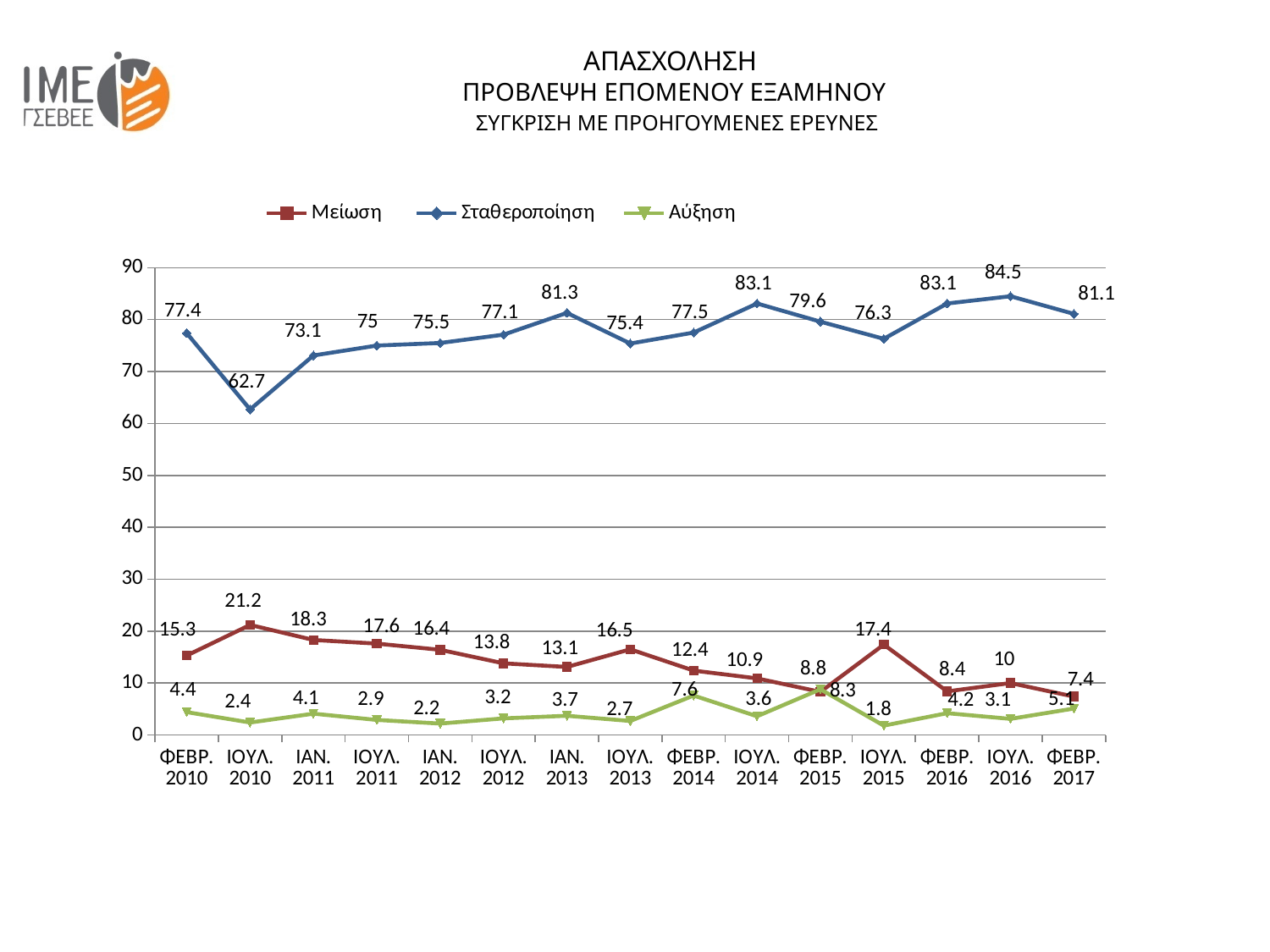
What is the difference between the Σταθεροποίηση values for ΙΟΥΛ. 2016 and ΦΕΒΡ. 2017? 3.4 In which period does Σταθεροποίηση have its lowest value? ΙΟΥΛ. 2010 In which period does Σταθεροποίηση reach its highest value? ΙΟΥΛ. 2016 How many survey periods are shown on the x axis? 15 What is the value of Μείωση for ΙΟΥΛ. 2015? 17.4 Which is larger, the Μείωση value for ΦΕΒΡ. 2010 or for ΙΑΝ. 2011? ΙΑΝ. 2011 What is the value of Αύξηση for ΦΕΒΡ. 2017? 5.1 Which series is shown in blue in the legend? Σταθεροποίηση What is the value of Σταθεροποίηση for ΙΟΥΛ. 2010? 62.7 In which period does Μείωση reach its highest value? ΙΟΥΛ. 2010 What type of chart is shown on the slide? line chart How many series does the legend list? 3